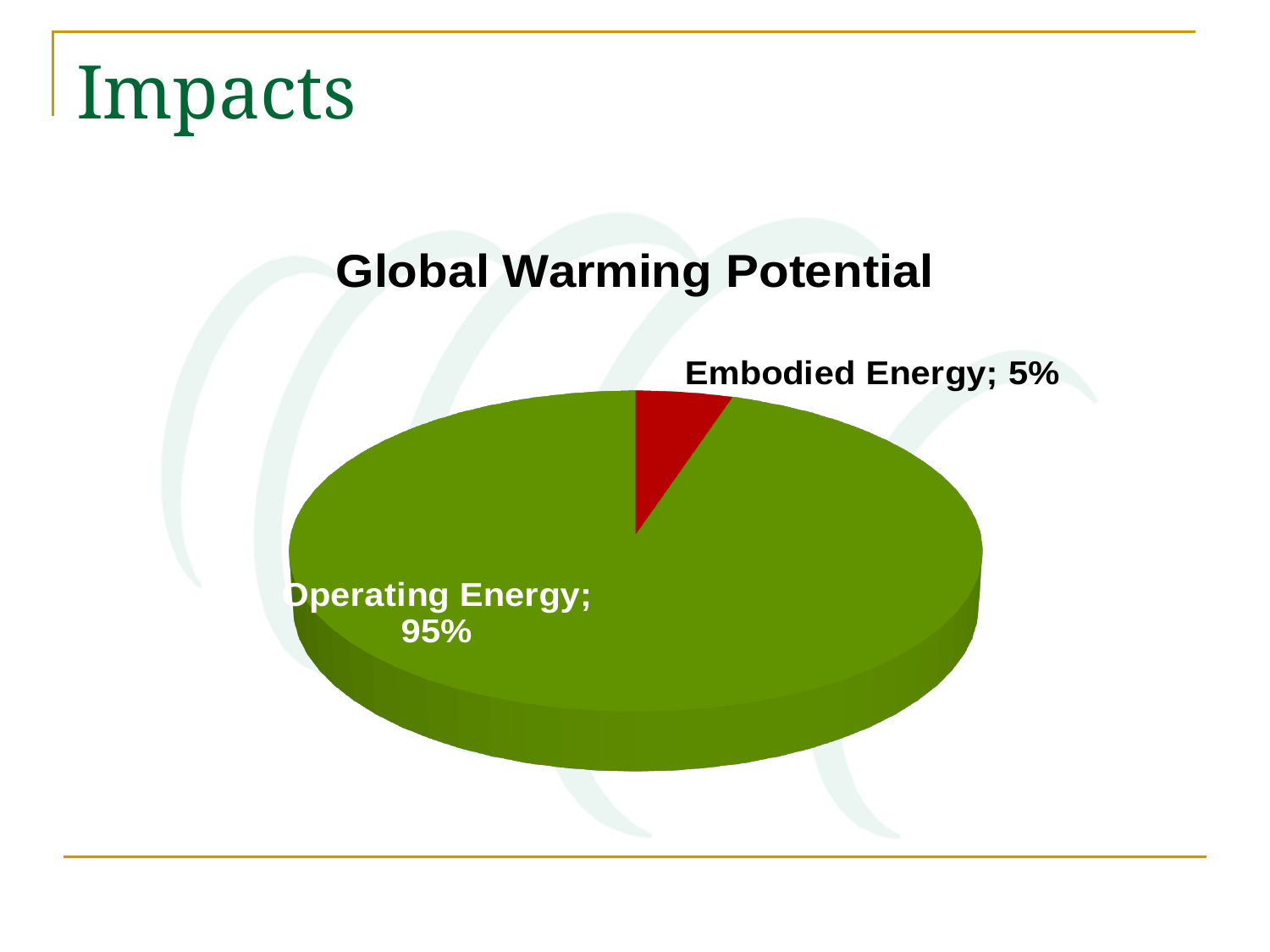
What colour is the Embodied Energy slice? red What type of chart is shown on the slide? pie chart What share of the pie does Operating Energy represent? 95% What share of the pie does Embodied Energy represent? 5% Which is larger, Operating Energy or Embodied Energy? Operating Energy What is the total of the two slices shown? 100% How many slices does the pie chart have? 2 Which slice is the largest? Operating Energy What is the title of the chart? Global Warming Potential What is the difference in percentage points between Operating Energy and Embodied Energy? 90 Which slice is the smallest? Embodied Energy